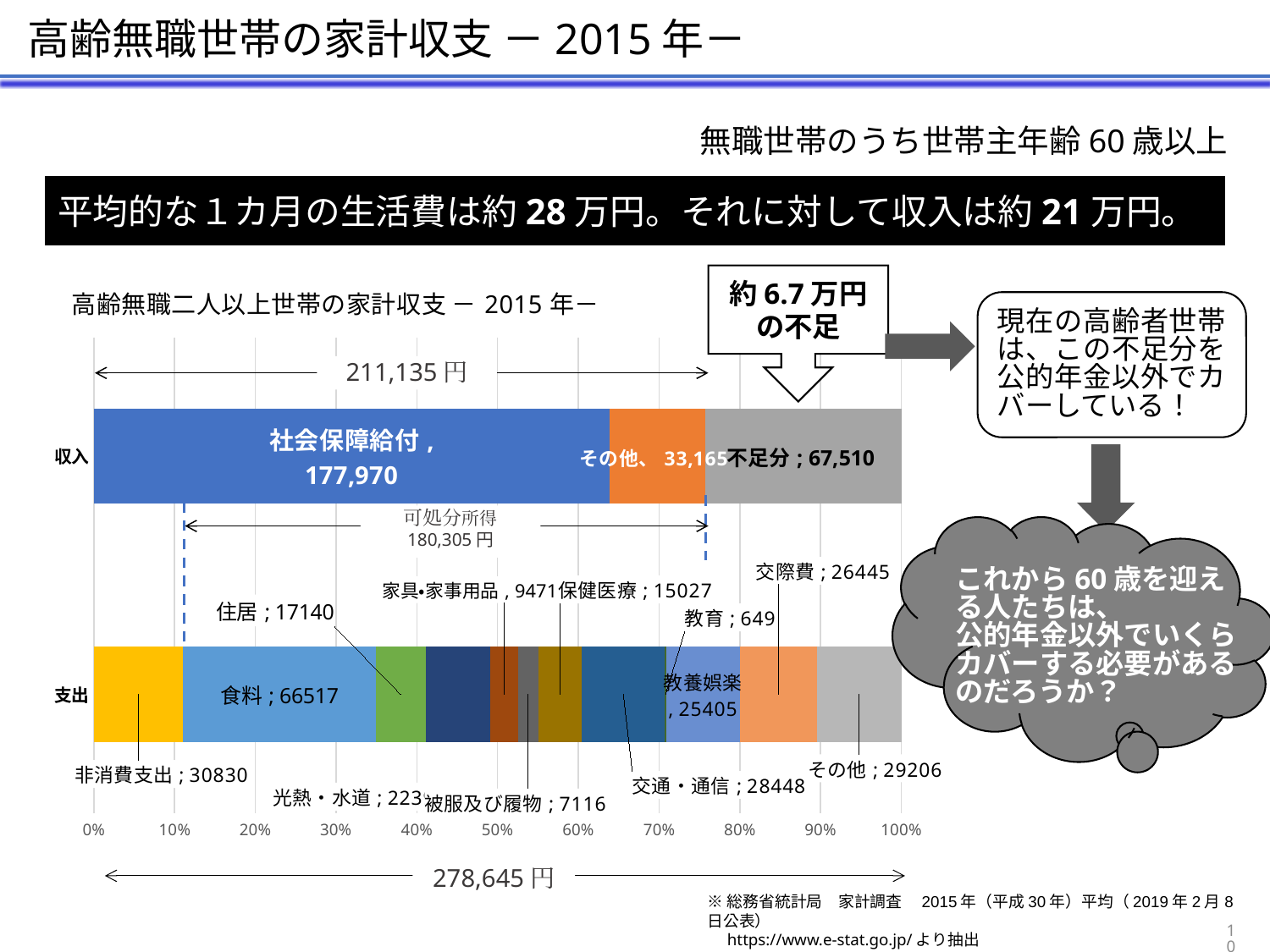
How many bars does the chart contain? 2 What is the value of 保健医療 in the 支出 bar? 15027 Which segment of the 支出 bar has the largest value? 食料 Which is larger in the 支出 bar, 交際費 or 教養娯楽? 交際費 Which segment of the 収入 bar has the smallest value? その他 What is the difference between 社会保障給付 and その他 in the 収入 bar? 144,805 What is the value of 不足分 in the 収入 bar? 67,510 What is the value of 社会保障給付 in the 収入 bar? 177,970 What is the value of 食料 in the 支出 bar? 66517 What kind of chart is shown on the slide? Stacked bar chart What is the value of 交通・通信 in the 支出 bar? 28448 What is the total of the 支出 bar as printed on the slide? 278,645 円